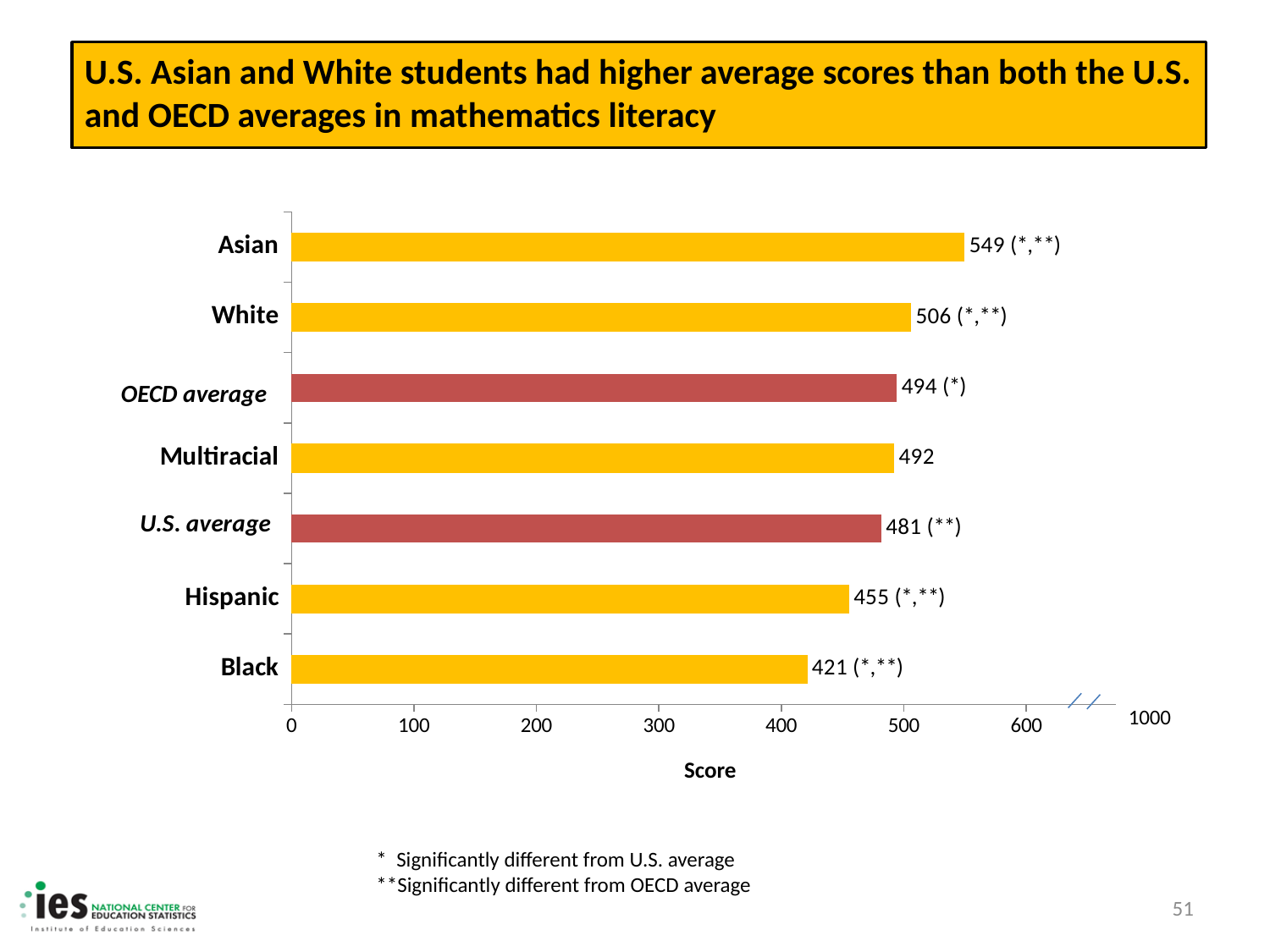
What is the average mathematics literacy score for Asian students? 549 What is the score shown for the OECD average? 494 Is the score for Black students greater or less than 500? less What kind of chart is shown on the slide? bar chart What is the difference between the Asian score and the White score? 43 Which is larger, the score for Multiracial students or the U.S. average? Multiracial Which category has the lowest score? Black What is the label of the horizontal axis? Score How many categories are shown on the chart? 7 What is the score shown for Hispanic students? 455 Which category has the highest score? Asian What is the difference between the OECD average and the U.S. average? 13